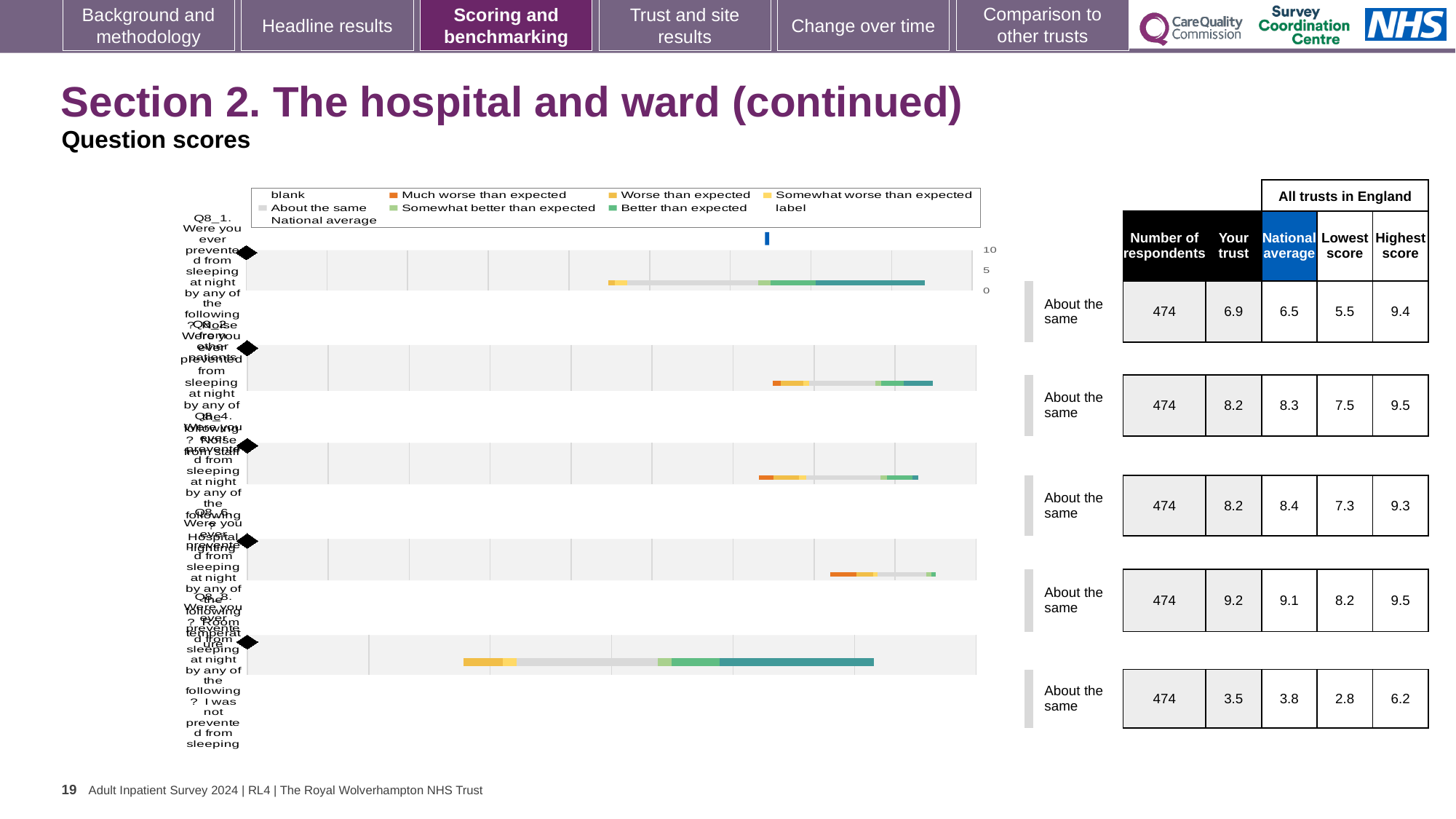
How many question rows (bars) are plotted in the chart? 5 For the fourth row, which is larger: the 'Your trust' score or the national average? Your trust (9.2) What is the national average for the first row (Q8_1)? 6.5 What is the 'Your trust' score for the first row (Q8_1)? 6.9 What benchmark rating is shown next to every bar in the chart? About the same What is the lowest score among all trusts in England for the last (fifth) row? 2.8 Which row has the lowest 'Your trust' score? the fifth row (3.5) Which row has the highest 'Your trust' score? the fourth row (9.2) What is the highest score among all trusts in England for the second row? 9.5 What kind of chart is used to show the question scores on this slide? bar chart What is the difference between the 'Your trust' score and the national average for the first row (Q8_1)? 0.4 What is the number of respondents for the first row (Q8_1)? 474